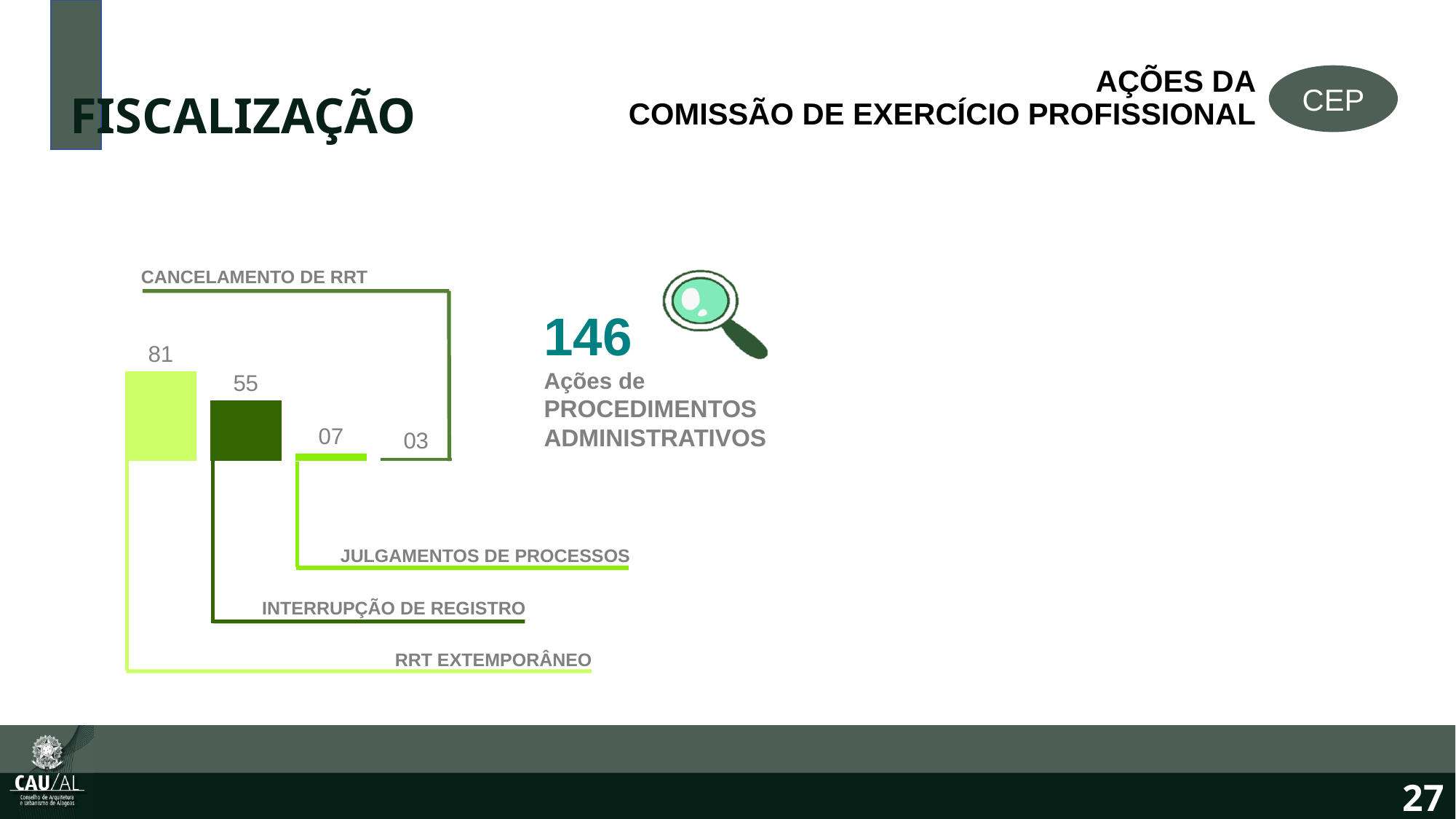
How many categories are shown in the chart? 4 What is the difference between the values for RRT EXTEMPORÂNEO and INTERRUPÇÃO DE REGISTRO? 26 What kind of chart is shown on the slide? Bar chart Which category has the lowest value? CANCELAMENTO DE RRT Which is larger, the value for INTERRUPÇÃO DE REGISTRO or the value for JULGAMENTOS DE PROCESSOS? INTERRUPÇÃO DE REGISTRO What is the total number of Ações de Procedimentos Administrativos shown on the slide? 146 What is the value for RRT EXTEMPORÂNEO? 81 What is the value for JULGAMENTOS DE PROCESSOS? 07 What is the value for CANCELAMENTO DE RRT? 03 What is the value for INTERRUPÇÃO DE REGISTRO? 55 What is the difference between the values for JULGAMENTOS DE PROCESSOS and CANCELAMENTO DE RRT? 4 Which category has the highest value? RRT EXTEMPORÂNEO